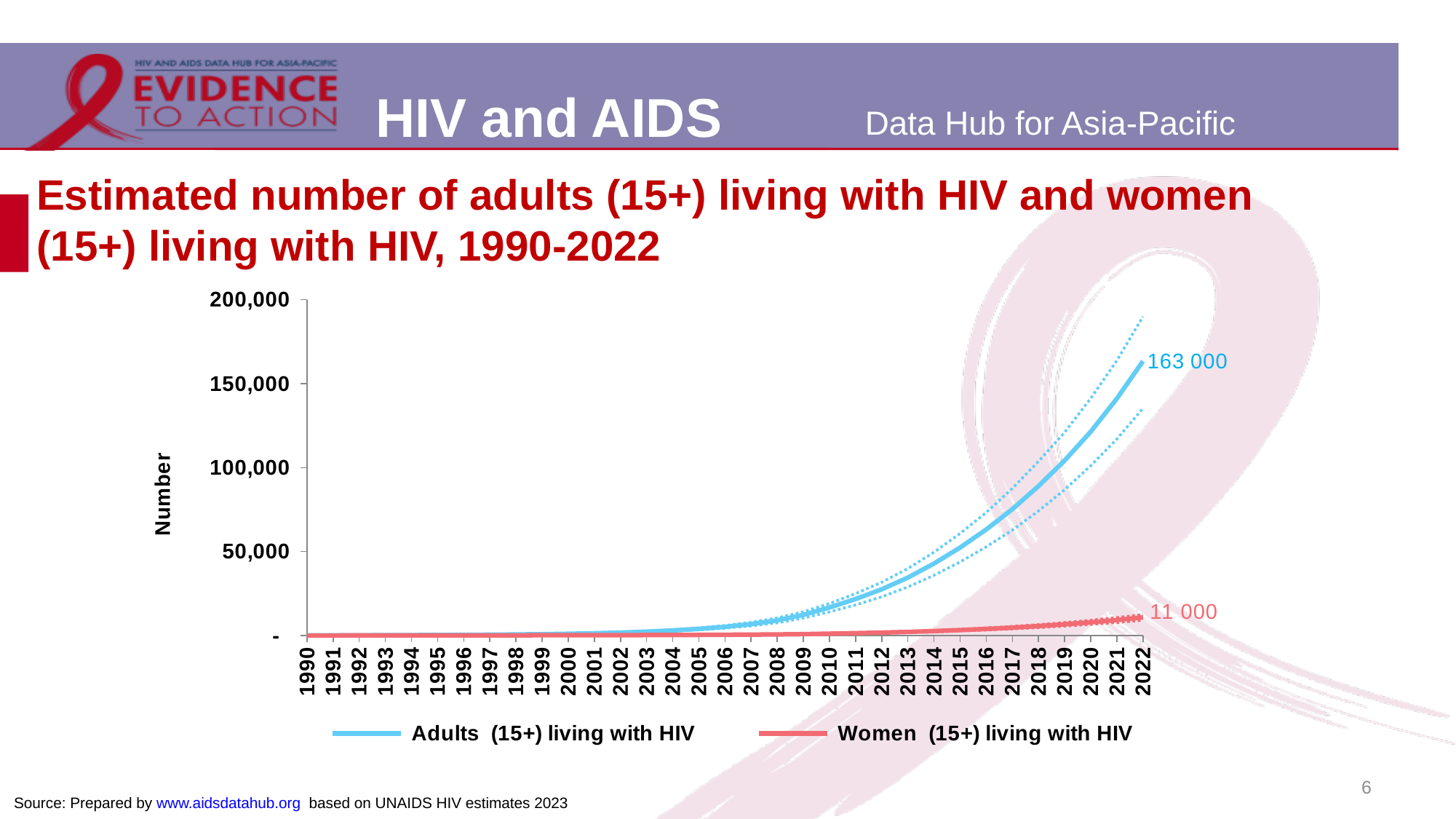
In 2022, which series has the larger value: Adults (15+) living with HIV or Women (15+) living with HIV? Adults (15+) living with HIV How many series does the legend list? 2 What kind of chart is shown on the slide? Line chart What is the estimated number of adults (15+) living with HIV in 2022? 163 000 Does the Adults (15+) living with HIV series rise or fall from 1990 to 2022? Rise How many years are shown on the x axis of the chart? 33 Is the value for Adults (15+) living with HIV in 2018 greater or less than 150,000? less Is the value for Women (15+) living with HIV in 2022 greater or less than 50,000? less What is the difference between the number of adults (15+) living with HIV and women (15+) living with HIV in 2022? 152 000 In which year does the Adults (15+) living with HIV series reach its highest value? 2022 Is the value for Adults (15+) living with HIV in 2010 greater or less than 50,000? less What is the estimated number of women (15+) living with HIV in 2022? 11 000